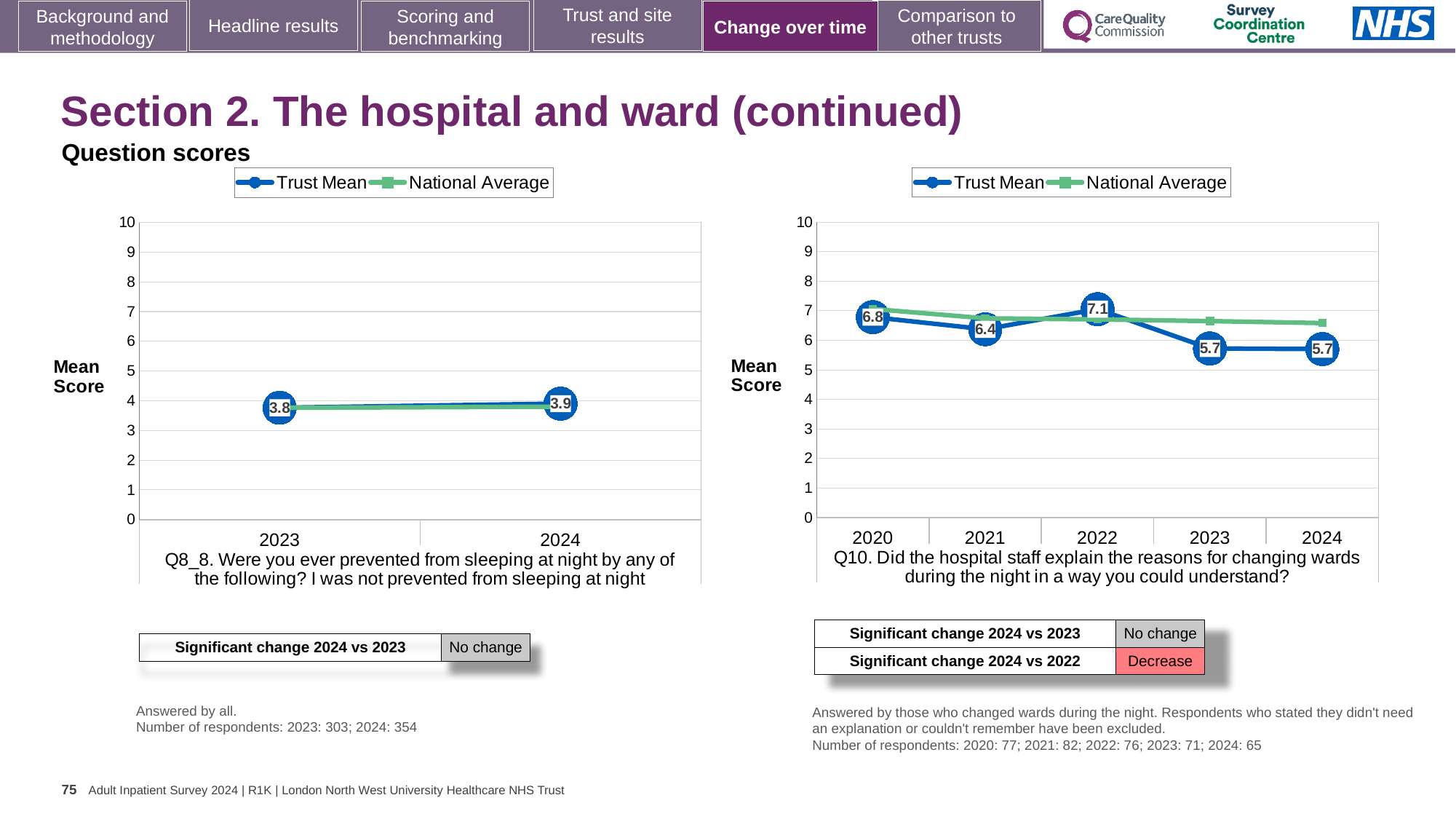
In the Q10 chart on the right, does the Trust Mean score rise or fall from 2022 to 2023? fall How many series does the legend of the Q8_8 chart on the left list? 2 In the Q10 chart on the right, what is the Trust Mean score for 2022? 7.1 In the Q8_8 chart on the left, what is the Trust Mean score for 2024? 3.9 In the Q8_8 chart on the left, what is the Trust Mean score for 2023? 3.8 In the Q10 chart on the right, which year has the highest Trust Mean score? 2022 In the Q10 chart on the right, is the National Average value for 2024 greater or less than 6? greater What type of chart is the Q10 chart on the right? line chart In the Q10 chart on the right, what is the Trust Mean score for 2021? 6.4 In the Q10 chart on the right, what is the difference between the Trust Mean scores for 2022 and 2024? 1.4 How many years are plotted on the x axis of the Q10 chart on the right? 5 In the Q10 chart on the right, is the Trust Mean score for 2020 larger or smaller than the score for 2021? larger